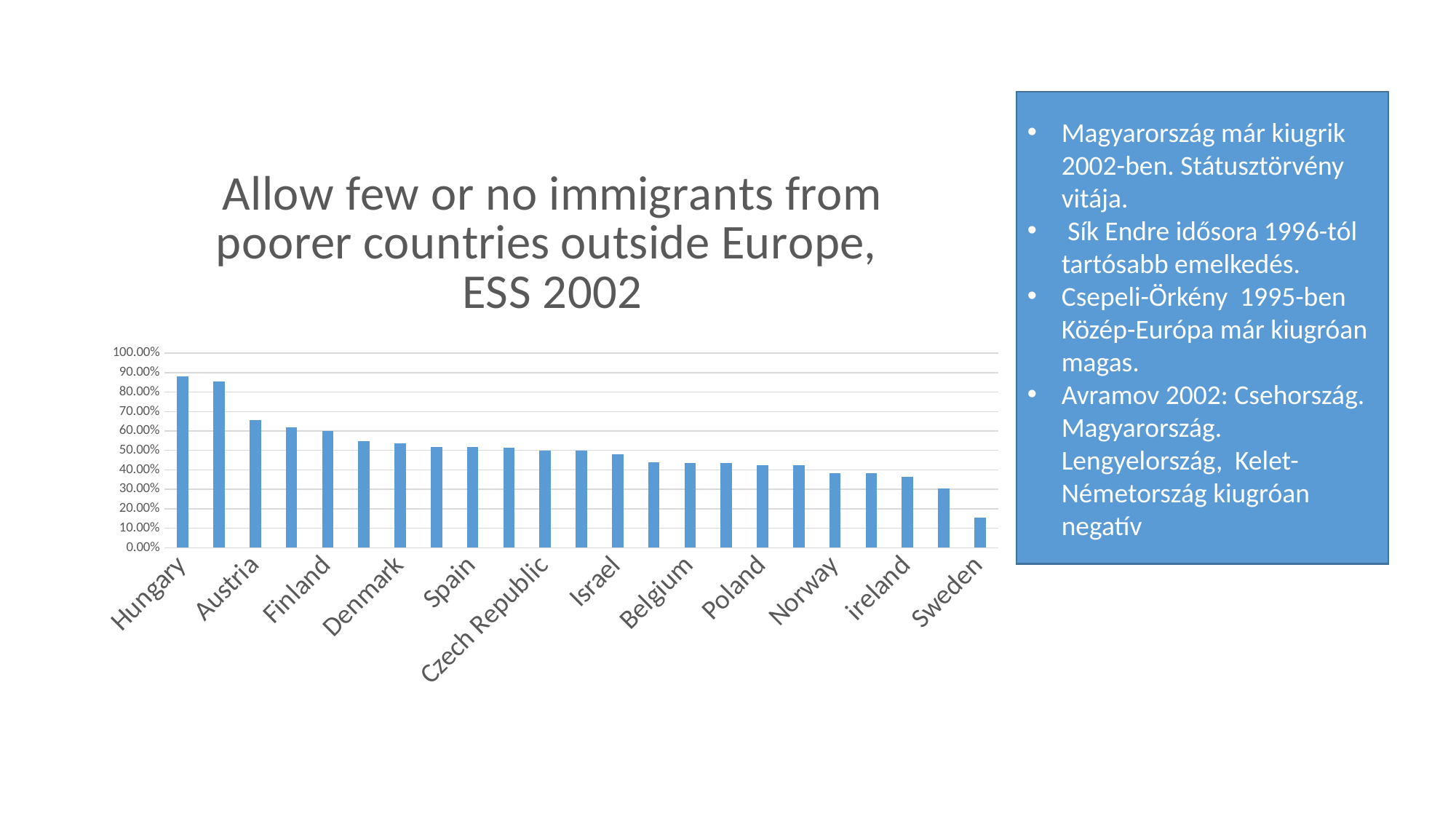
Is the value for Belgium greater or less than 50.00%? less What kind of chart is shown on the slide? bar chart Is the value for Hungary greater or less than 80.00%? greater What is the title of the chart? Allow few or no immigrants from poorer countries outside Europe, ESS 2002 Which labelled country has the highest value in the chart? Hungary Is the value for Denmark greater or less than 50.00%? greater Do the values rise or fall moving from left to right along the x axis? fall Which has a larger value, Poland or Hungary? Hungary Which labelled country has the lowest value in the chart? Sweden Which has a larger value, Austria or Finland? Austria